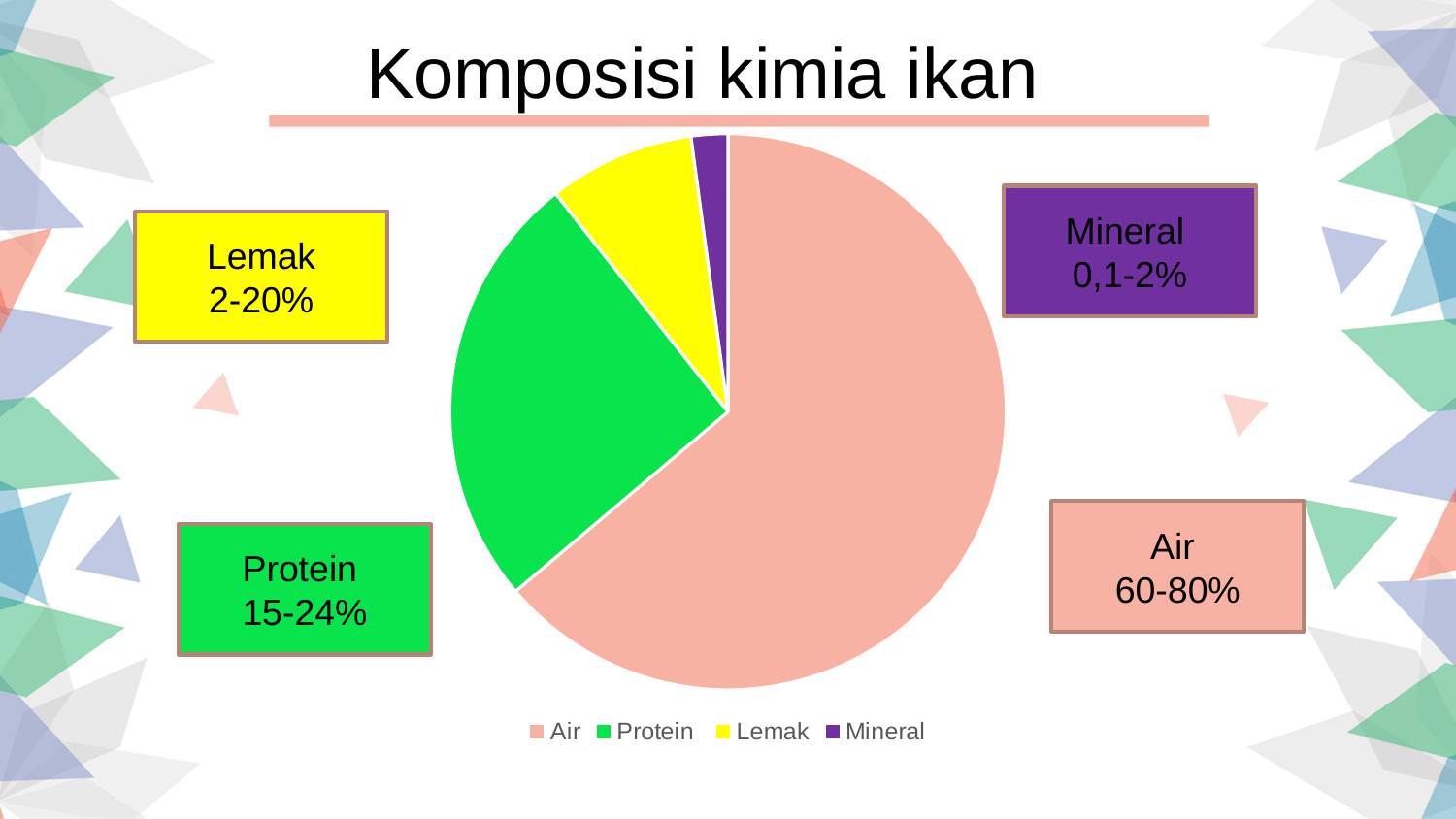
Which category has the smallest slice of the pie? Mineral What percentage range is shown for Air? 60-80% What percentage range is shown for Mineral? 0,1-2% What colour is the Lemak slice in the pie chart? yellow How many slices does the pie chart have? 4 What is the title of the chart? Komposisi kimia ikan Which slice is larger, Lemak or Mineral? Lemak How many entries does the legend list? 4 What percentage range is shown for Protein? 15-24% What kind of chart is shown on the slide? pie chart Which slice is larger, Protein or Lemak? Protein Which category has the largest slice of the pie? Air